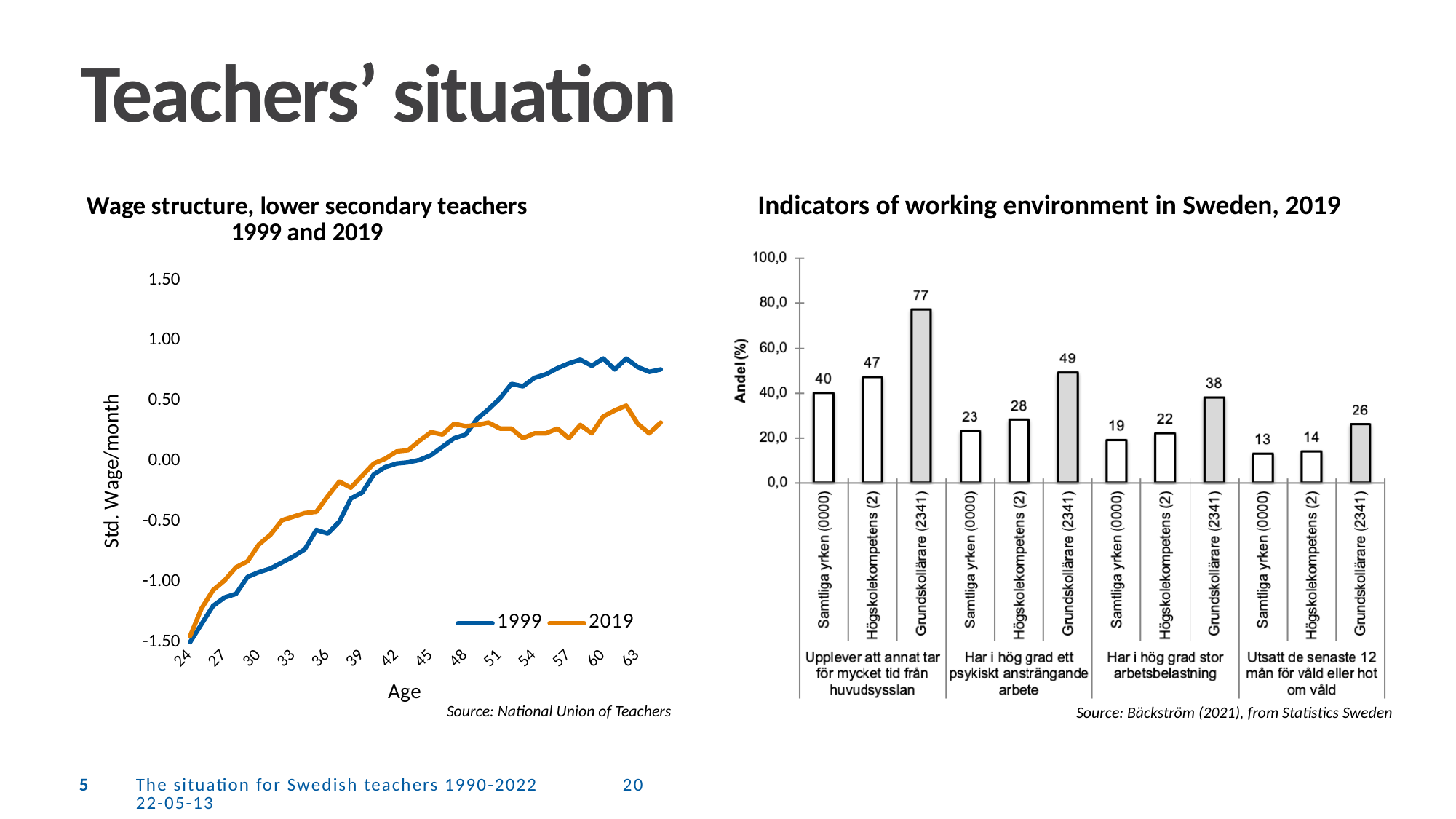
On the 'Indicators of working environment in Sweden, 2019' chart, which bar has the lowest value? Samtliga yrken (0000), Utsatt de senaste 12 mån för våld eller hot om våld On the 'Wage structure, lower secondary teachers 1999 and 2019' chart, is the value for the 1999 series at age 60 greater or less than 0.50? greater On the 'Indicators of working environment in Sweden, 2019' chart, which is larger: Högskolekompetens (2) in 'Har i hög grad stor arbetsbelastning' or Grundskollärare (2341) in 'Utsatt de senaste 12 mån för våld eller hot om våld'? Grundskollärare (2341) in 'Utsatt de senaste 12 mån för våld eller hot om våld' What kind of chart is the 'Wage structure, lower secondary teachers 1999 and 2019' chart? Line chart How many series does the legend of the 'Wage structure, lower secondary teachers 1999 and 2019' chart list? 2 On the 'Indicators of working environment in Sweden, 2019' chart, what is the value for Högskolekompetens (2) in the group 'Utsatt de senaste 12 mån för våld eller hot om våld'? 14 On the 'Indicators of working environment in Sweden, 2019' chart, what is the value for Samtliga yrken (0000) in the group 'Har i hög grad stor arbetsbelastning'? 19 On the 'Indicators of working environment in Sweden, 2019' chart, which bar has the highest value? Grundskollärare (2341), Upplever att annat tar för mycket tid från huvudsysslan On the 'Indicators of working environment in Sweden, 2019' chart, how many bars are plotted? 12 On the 'Wage structure, lower secondary teachers 1999 and 2019' chart, which series is higher at age 60: 1999 or 2019? 1999 On the 'Indicators of working environment in Sweden, 2019' chart, what is the difference between Grundskollärare (2341) and Samtliga yrken (0000) in the group 'Har i hög grad ett psykiskt ansträngande arbete'? 26 On the 'Indicators of working environment in Sweden, 2019' chart, what is the value for Grundskollärare (2341) in the group 'Upplever att annat tar för mycket tid från huvudsysslan'? 77